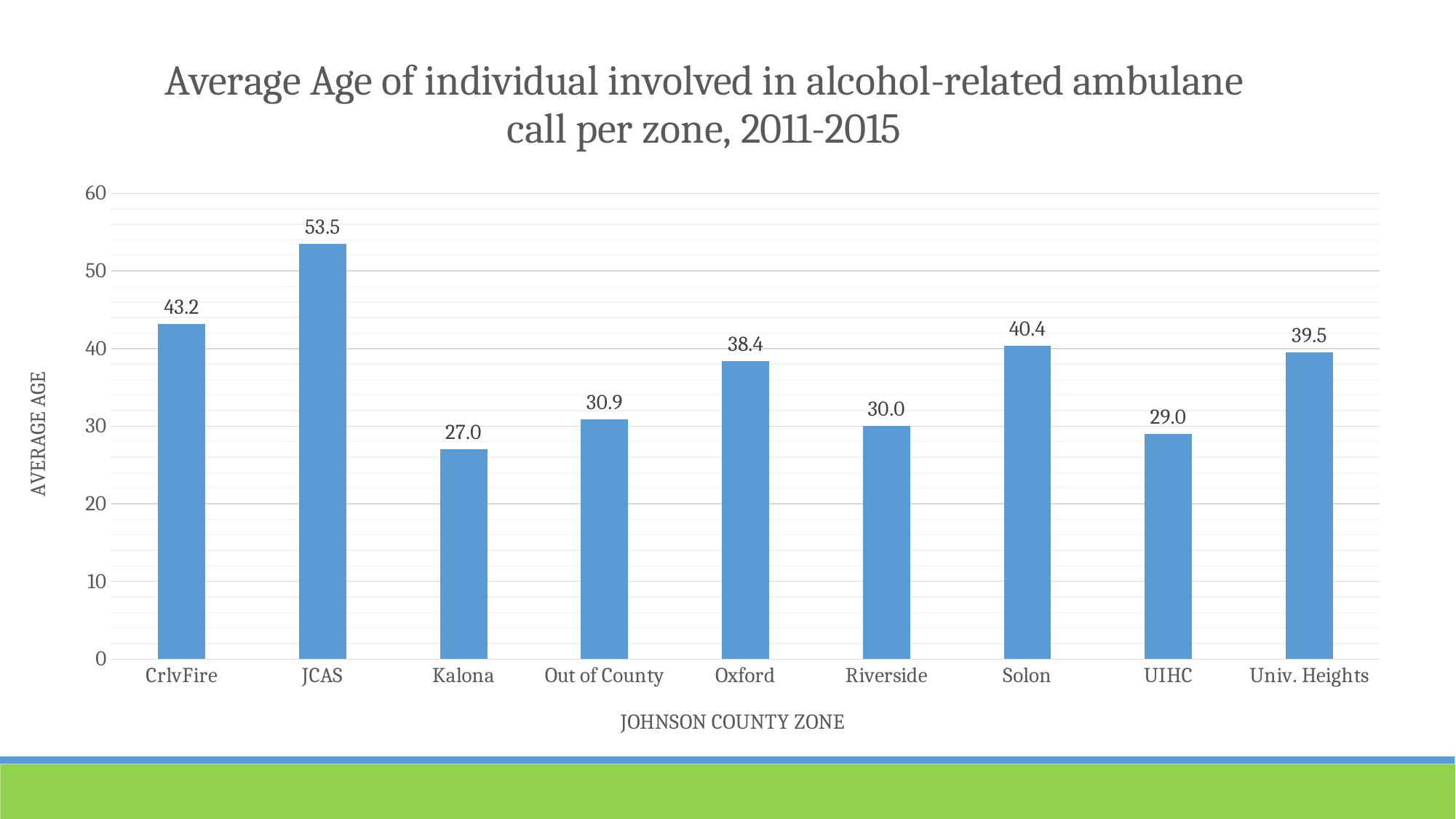
Which has a higher average age, Oxford or Riverside? Oxford How many zones are shown on the chart? 9 Which zone has the lowest average age? Kalona What is the average age for Univ. Heights? 39.5 What is the average age for JCAS? 53.5 What kind of chart is shown on the slide? bar chart What is the label of the x axis? JOHNSON COUNTY ZONE What is the average age for Kalona? 27.0 What is the difference between the average age for JCAS and CrlvFire? 10.3 What is the difference between the average age for Solon and UIHC? 11.4 Is the value for Out of County greater or less than 40? less Which zone has the highest average age? JCAS